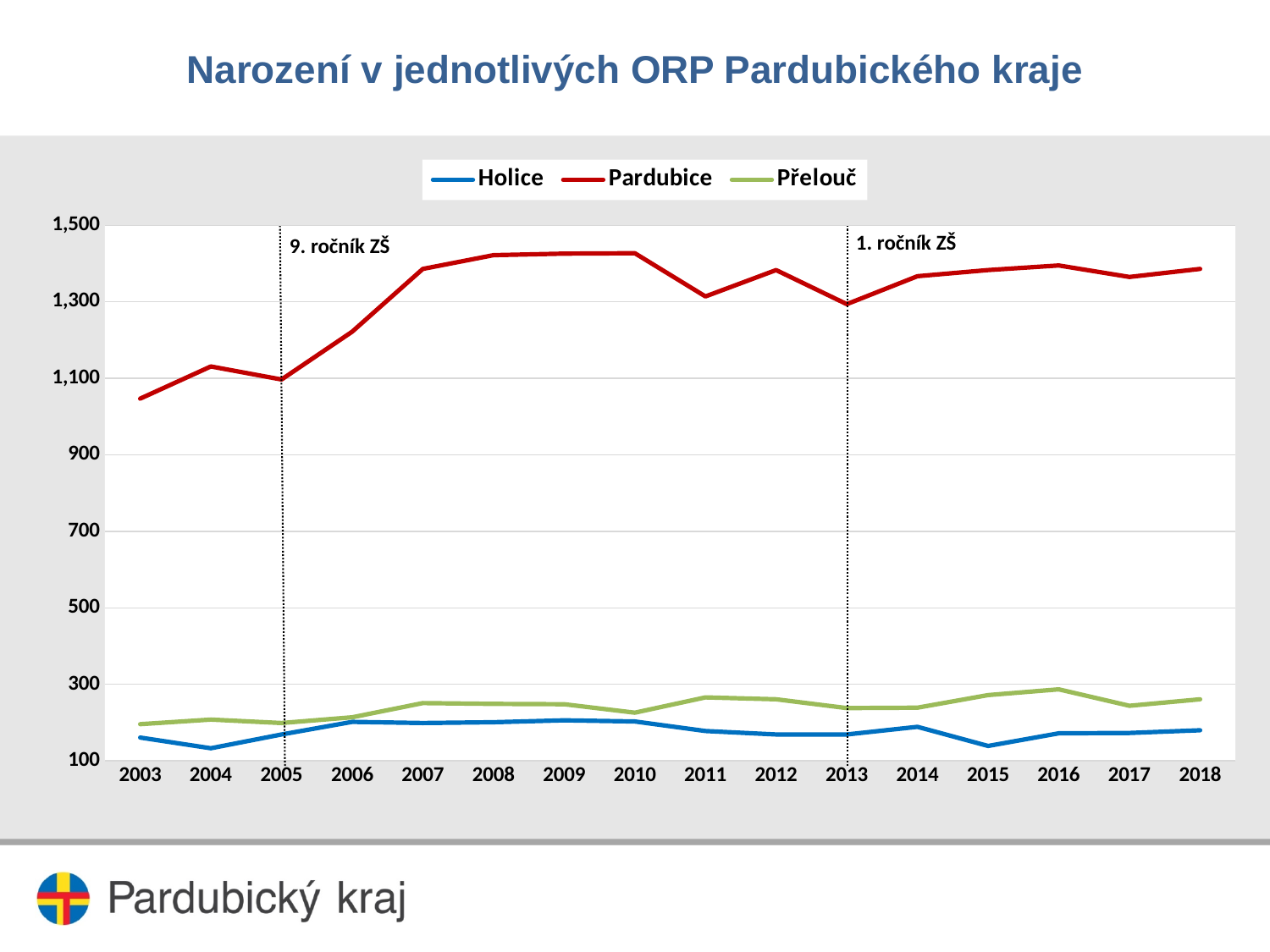
How many series does the legend list? 3 How many years are shown on the x axis? 16 Is the value for Pardubice in 2009 greater or less than 1,300? greater Which is larger in 2011, the value for Přelouč or the value for Holice? Přelouč Which series has the highest values throughout the chart? Pardubice What kind of chart is shown on the slide? line chart Is the value for Přelouč in 2016 greater or less than 300? less Is the value for Pardubice in 2003 greater or less than 1,100? less Which series has the lowest values in 2018? Holice What is the title of the chart? Narození v jednotlivých ORP Pardubického kraje What label is shown at the dotted vertical line at 2013? 1. ročník ZŠ Do the values for Pardubice rise or fall from 2003 to 2007? rise